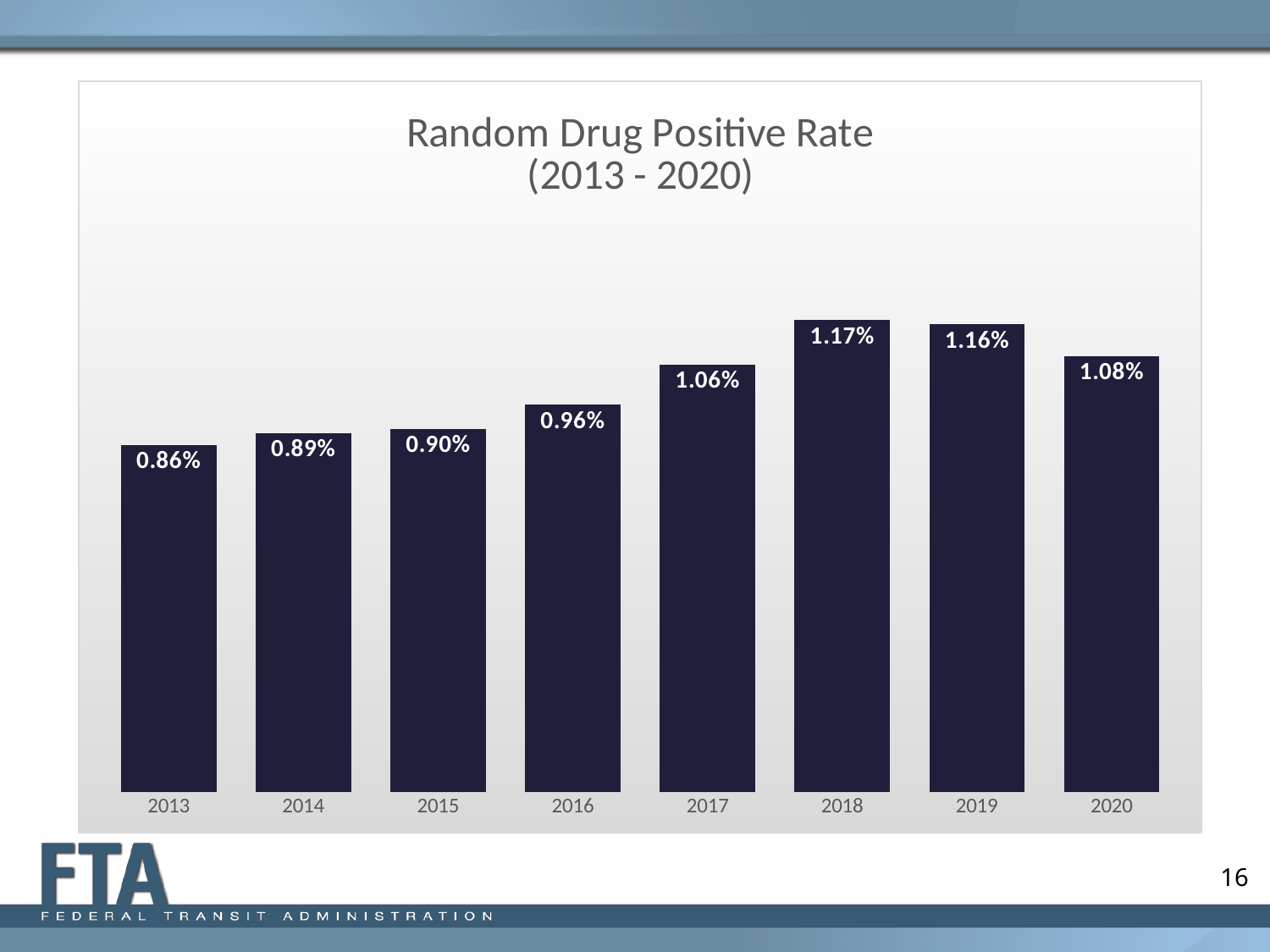
What is the difference between the random drug positive rate in 2019 and in 2020? 0.08% Does the random drug positive rate rise or fall from 2013 to 2018? Rise Which year has the lowest random drug positive rate? 2013 What is the random drug positive rate for 2017? 1.06% What is the random drug positive rate for 2020? 1.08% What is the title of the chart? Random Drug Positive Rate (2013 - 2020) What kind of chart is shown on the slide? Bar chart Which year has a higher random drug positive rate, 2016 or 2020? 2020 What is the difference between the random drug positive rate in 2018 and in 2013? 0.31% Which year has the highest random drug positive rate? 2018 How many years are shown on the chart? 8 What is the random drug positive rate for 2013? 0.86%